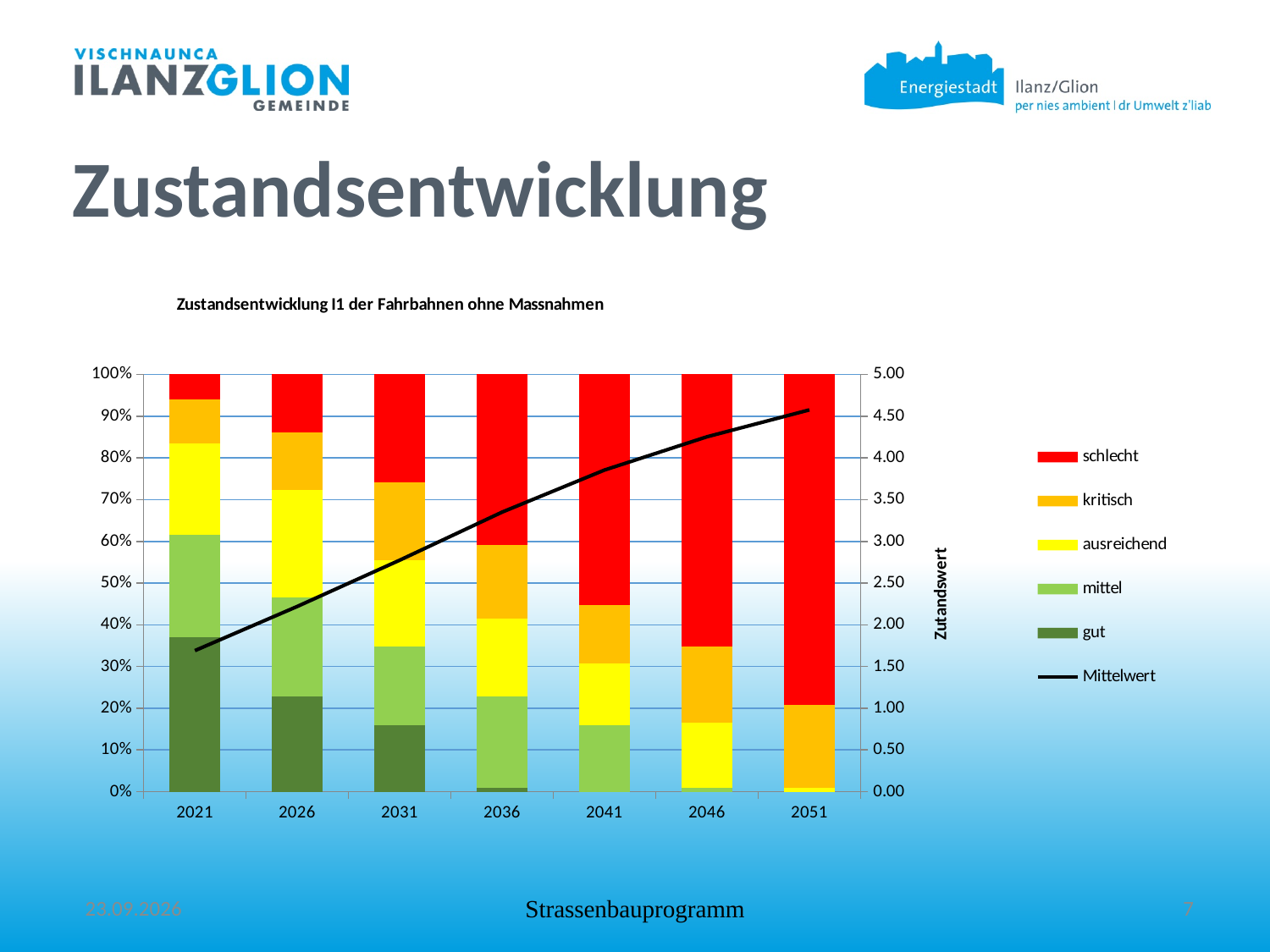
In which year is the Mittelwert lowest? 2021 What is the title of the chart? Zustandsentwicklung I1 der Fahrbahnen ohne Massnahmen What kind of chart is shown on the slide? A stacked bar chart with a line How many series does the chart legend list? 6 Which year has the larger share of 'gut', 2021 or 2031? 2021 Is the Mittelwert for 2051 greater or less than 4.00? greater What is the title of the right-hand (secondary) axis? Zutandswert Does the Mittelwert line rise or fall from 2021 to 2051? Rise Is the share of 'schlecht' in 2051 greater or less than 70%? greater Is the Mittelwert for 2021 greater or less than 2.00? less In which year is the Mittelwert highest? 2051 How many years are shown on the x axis of the chart? 7